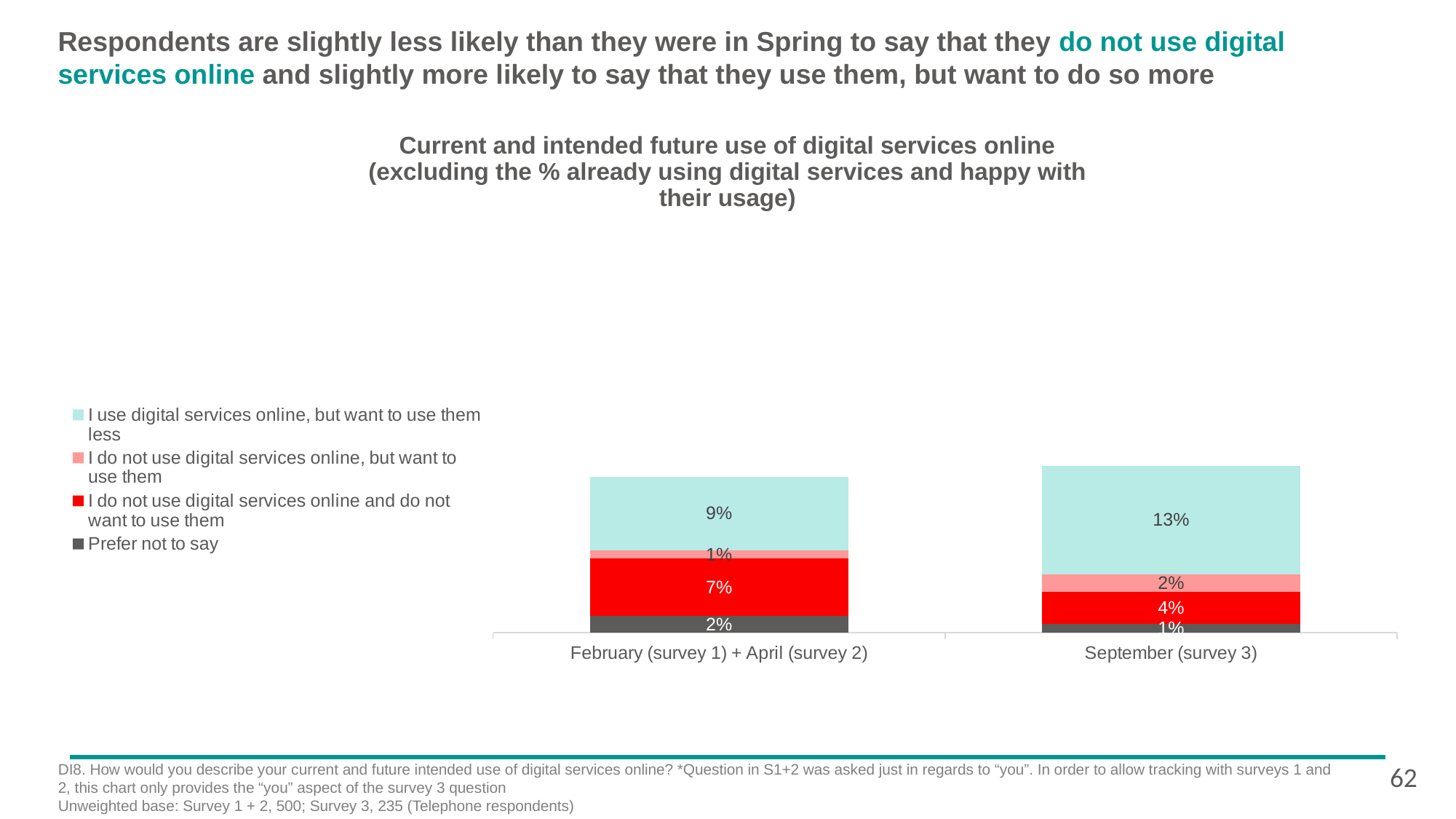
What is the total of the stacked bar for February (survey 1) + April (survey 2)? 19% What is the value for 'Prefer not to say' in September (survey 3)? 1% What is the total of the stacked bar for September (survey 3)? 20% What kind of chart is shown on the slide? Stacked bar chart What is the difference between the 'I use digital services online, but want to use them less' values for September (survey 3) and February (survey 1) + April (survey 2)? 4% What is the value for 'I do not use digital services online, but want to use them' in February (survey 1) + April (survey 2)? 1% What is the value for 'I use digital services online, but want to use them less' in September (survey 3)? 13% What is the title of the chart? Current and intended future use of digital services online (excluding the % already using digital services and happy with their usage) What is the value for 'I do not use digital services online and do not want to use them' in February (survey 1) + April (survey 2)? 7% How many categories are shown on the x axis? 2 Which category has the larger value for 'I do not use digital services online and do not want to use them'? February (survey 1) + April (survey 2) How many series does the legend list? 4